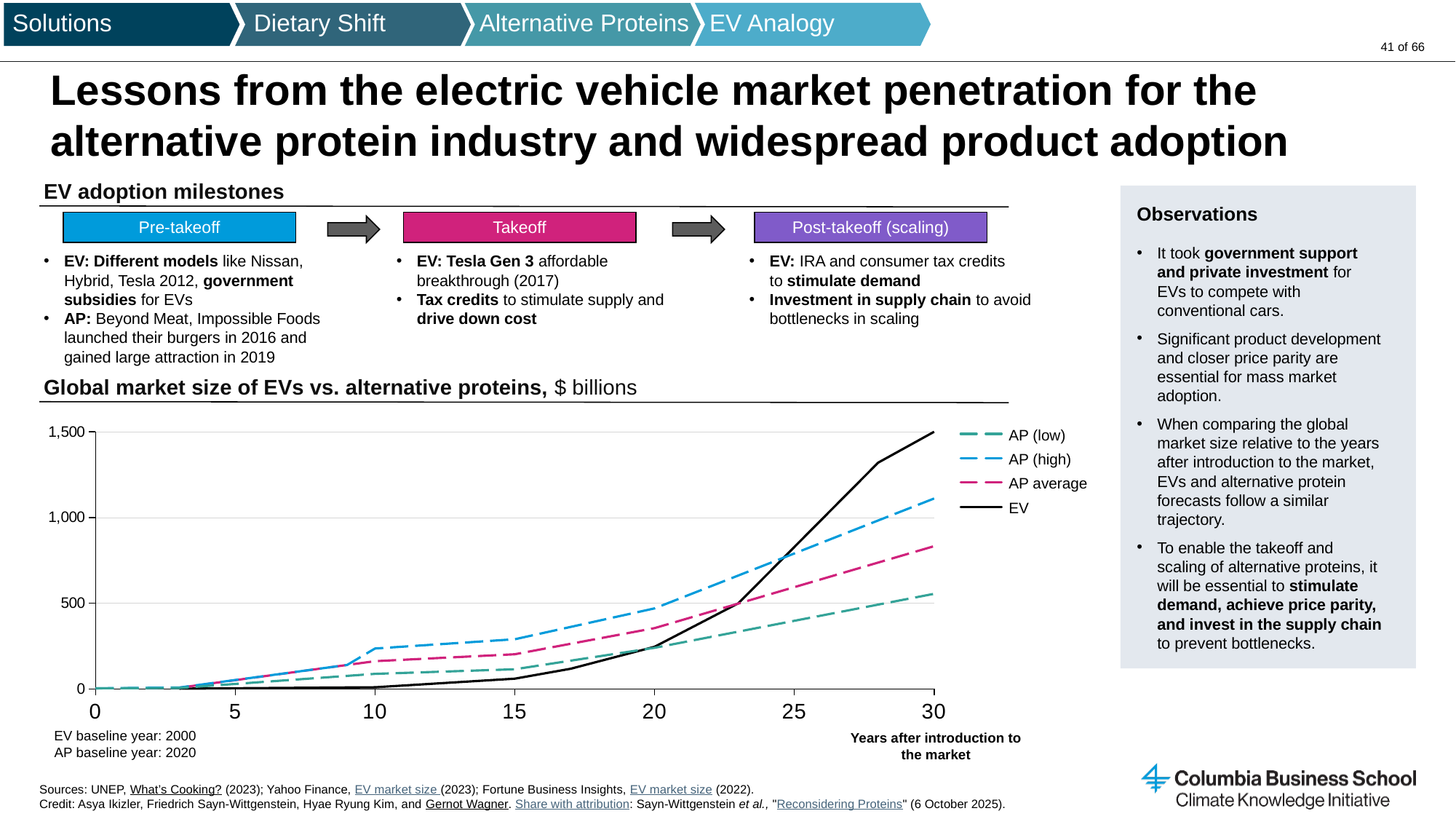
In what unit is the global market size chart expressed? $ billions At 10 years after introduction, which is larger: AP (high) or EV? AP (high) Is the AP (high) value at 30 years after introduction greater or less than 1,000? greater What kind of chart is used to show the global market size of EVs vs. alternative proteins? Line chart Is the EV value at 15 years after introduction greater or less than 500? less Is the AP (low) value at 30 years after introduction greater or less than 1,000? less Which series has the lowest value at 30 years after introduction to the market? AP (low) What is the x-axis label of the global market size chart? Years after introduction to the market Does the EV series rise or fall as the years after introduction increase? Rise How many series does the legend of the global market size chart list? 4 Which series has the highest value at 30 years after introduction to the market? EV